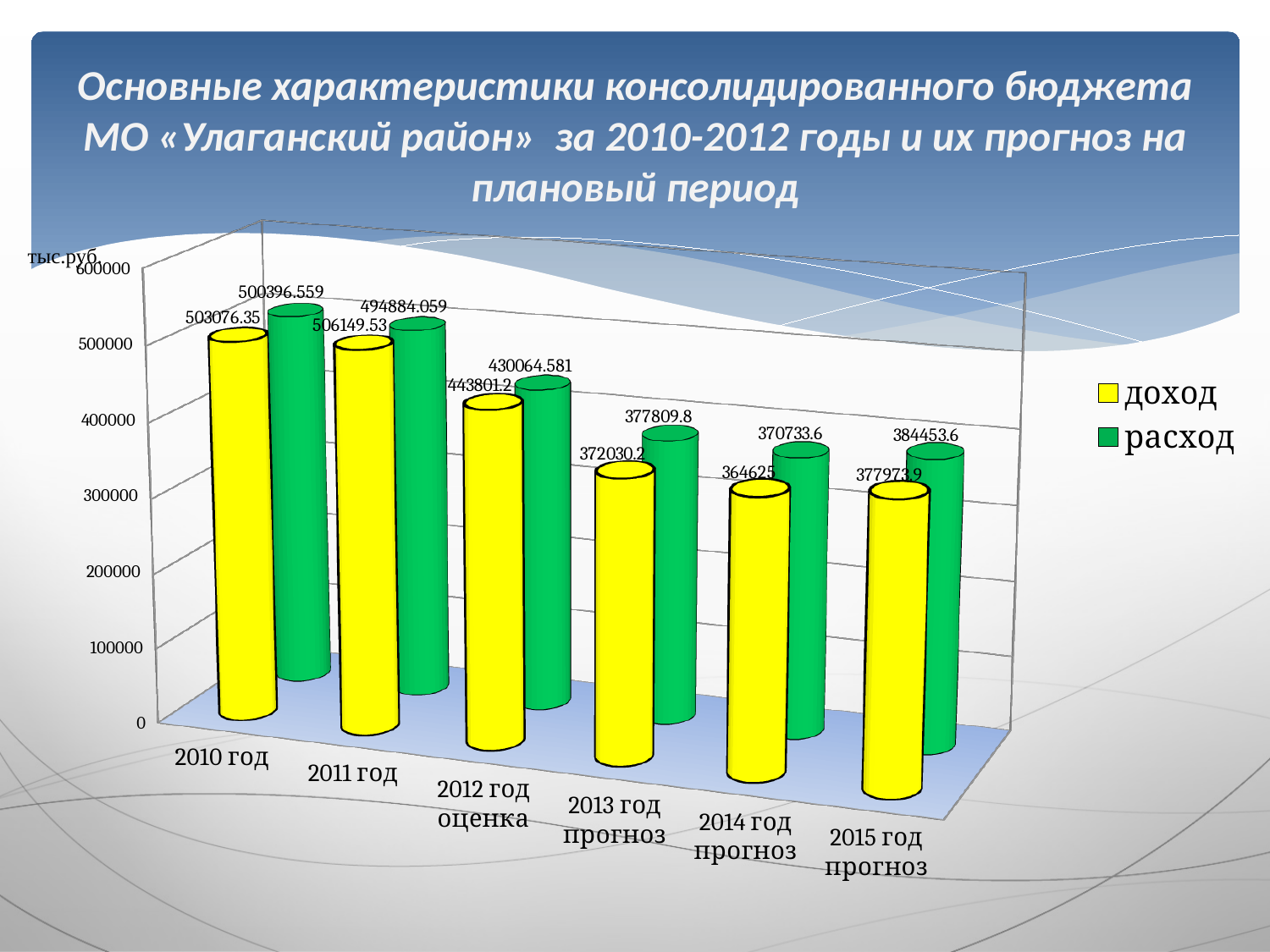
In which year is расход the lowest? 2014 год прогноз Does расход rise or fall from 2010 год to 2014 год прогноз? fall What is the value of доход for 2014 год прогноз? 364625 How many series does the legend list? 2 What is the difference between доход and расход for 2012 год оценка? 13736.619 What is the difference between расход and доход for 2014 год прогноз? 6108.6 What is the value of расход for 2012 год оценка? 430064.581 What is the value of расход for 2015 год прогноз? 384453.6 For 2013 год прогноз, which is larger: доход or расход? расход In which year is доход the highest? 2011 год What is the value of доход for 2010 год? 503076.35 How many year categories are shown on the x axis? 6